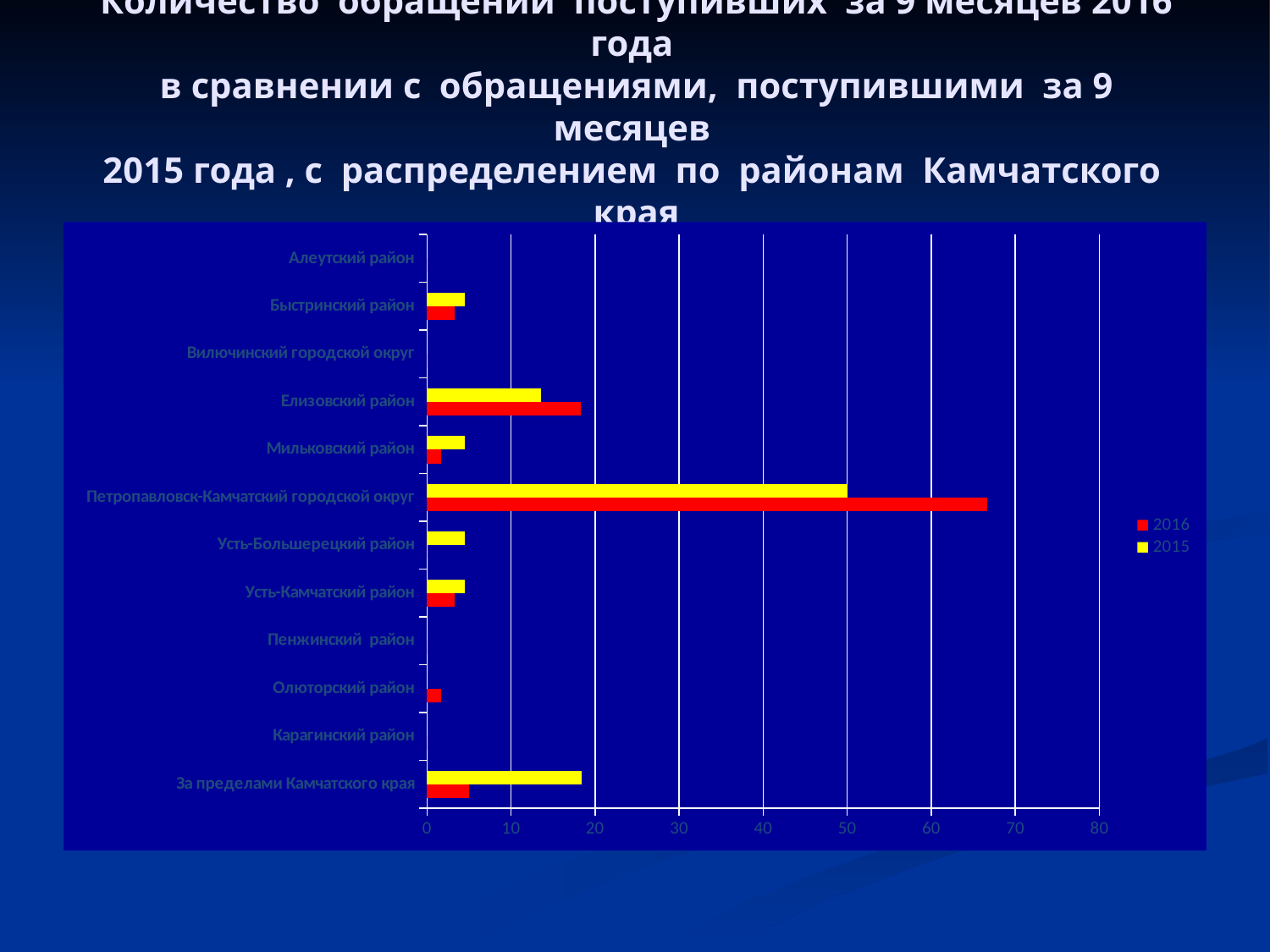
Which category has the highest value for the 2016 series? Петропавловск-Камчатский городской округ Is the 2015 value for Елизовский район greater or less than 20? less How many series does the legend list? 2 For Петропавловск-Камчатский городской округ, which series has the larger value, 2016 or 2015? 2016 Is the 2016 value for Петропавловск-Камчатский городской округ greater or less than 60? greater Which two series are listed in the legend? 2016 and 2015 Which colour represents the 2015 series in the chart? yellow For За пределами Камчатского края, which series has the larger value, 2016 or 2015? 2015 Is the 2016 value for За пределами Камчатского края greater or less than 10? less How many districts (categories) are listed on the vertical axis? 12 What kind of chart is shown on the slide? bar chart Which category has the highest value for the 2015 series? Петропавловск-Камчатский городской округ